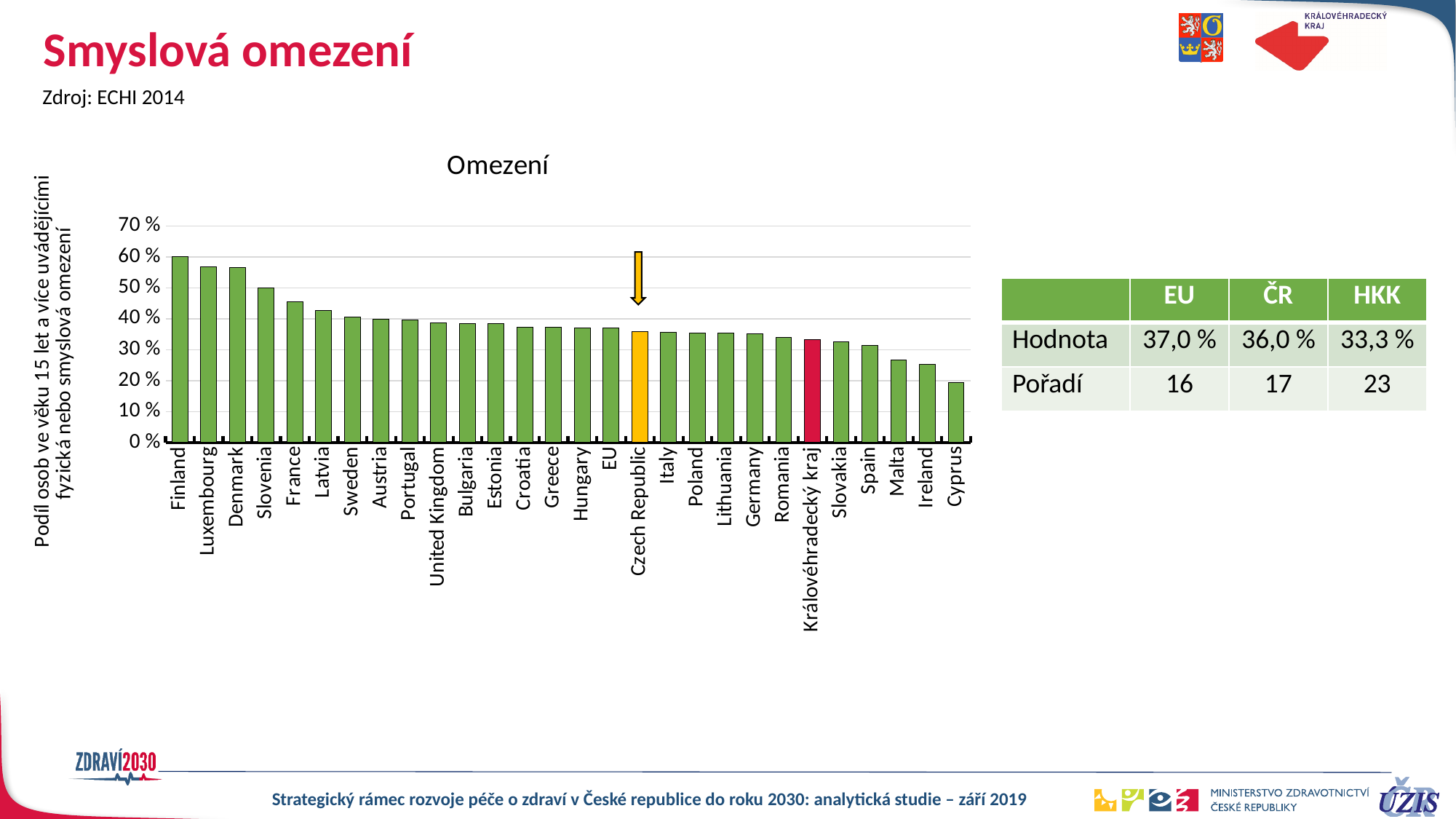
What kind of chart is shown on the slide? bar chart Is the value for Cyprus greater or less than 30 %? less Which category has the lowest value in the chart? Cyprus According to the table, what is the value (Hodnota) for Královéhradecký kraj (HKK)? 33,3 % Is the value for France greater or less than 40 %? greater What is the difference between the EU value and the ČR value shown in the table? 1,0 % What is the title of the chart? Omezení Which category has the highest value in the chart? Finland Do the values rise or fall from left to right along the x axis? fall Which has the larger value, Finland or Luxembourg? Finland How many categories (bars) are plotted in the chart? 28 Is the value for Finland greater or less than 50 %? greater